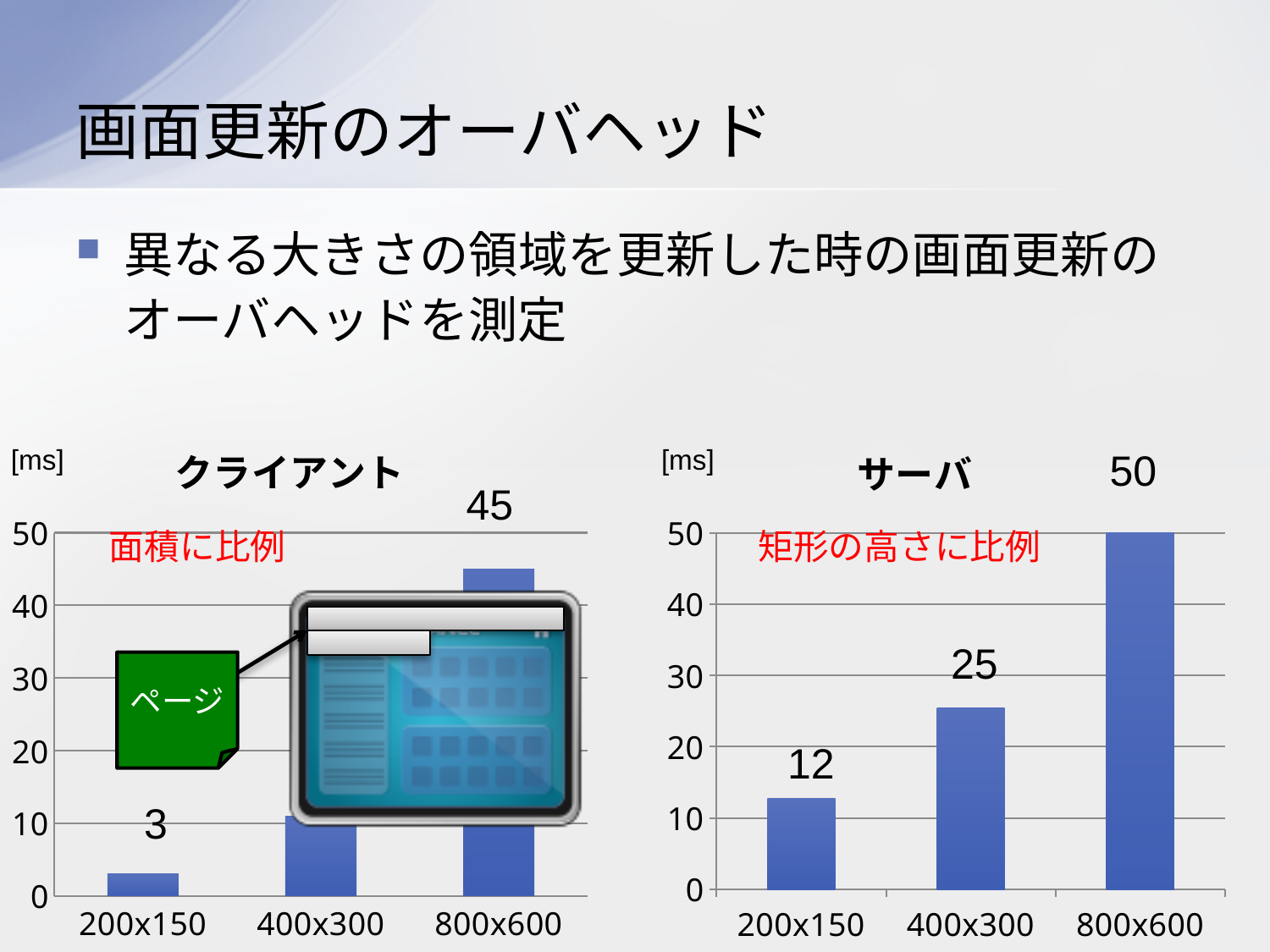
In the サーバ chart, what is the value for 200x150? 12 How many categories does the サーバ chart show? 3 In the サーバ chart, what is the value for 800x600? 50 In the サーバ chart, what is the value for 400x300? 25 In the クライアント chart, what is the difference between the values for 800x600 and 200x150? 42 In the クライアント chart, what is the value for 200x150? 3 In the クライアント chart, what is the value for 800x600? 45 In the サーバ chart, what is the difference between the values for 800x600 and 200x150? 38 What kind of chart is the サーバ chart? bar chart In the クライアント chart, which category has the lowest value? 200x150 In the サーバ chart, which category has the highest value? 800x600